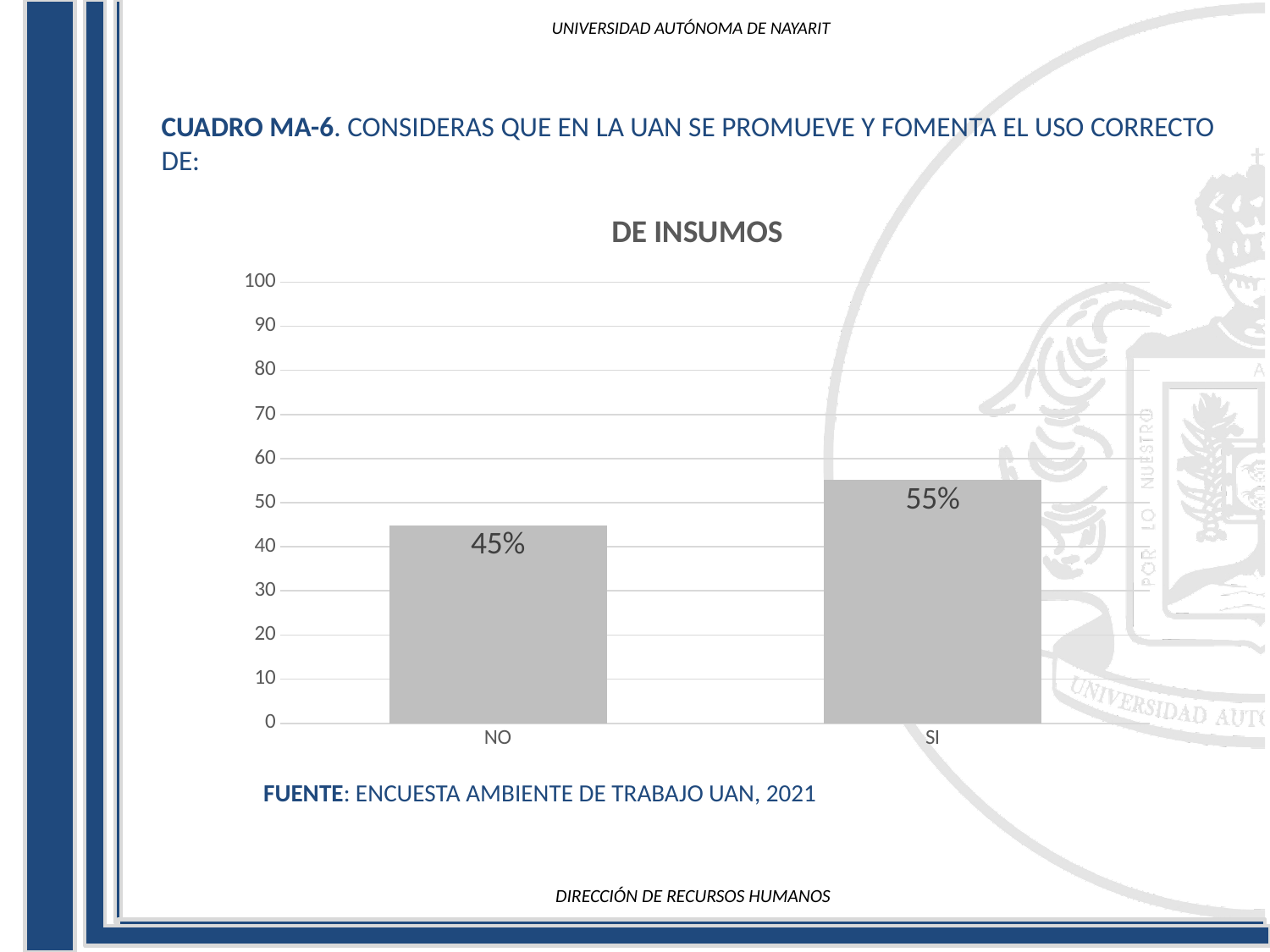
What is the value for NO? 45% What is the value for SI? 55% Is the value for SI greater or less than 50? greater Is the value for NO greater or less than 50? less Which is larger, the value for NO or the value for SI? SI How many categories are shown on the x axis? 2 What is the title of the chart? DE INSUMOS What kind of chart is shown on the slide? bar chart Which category has the lowest value? NO Which category has the highest value? SI What is the difference between the values for SI and NO? 10% What is the highest value shown on the vertical axis? 100